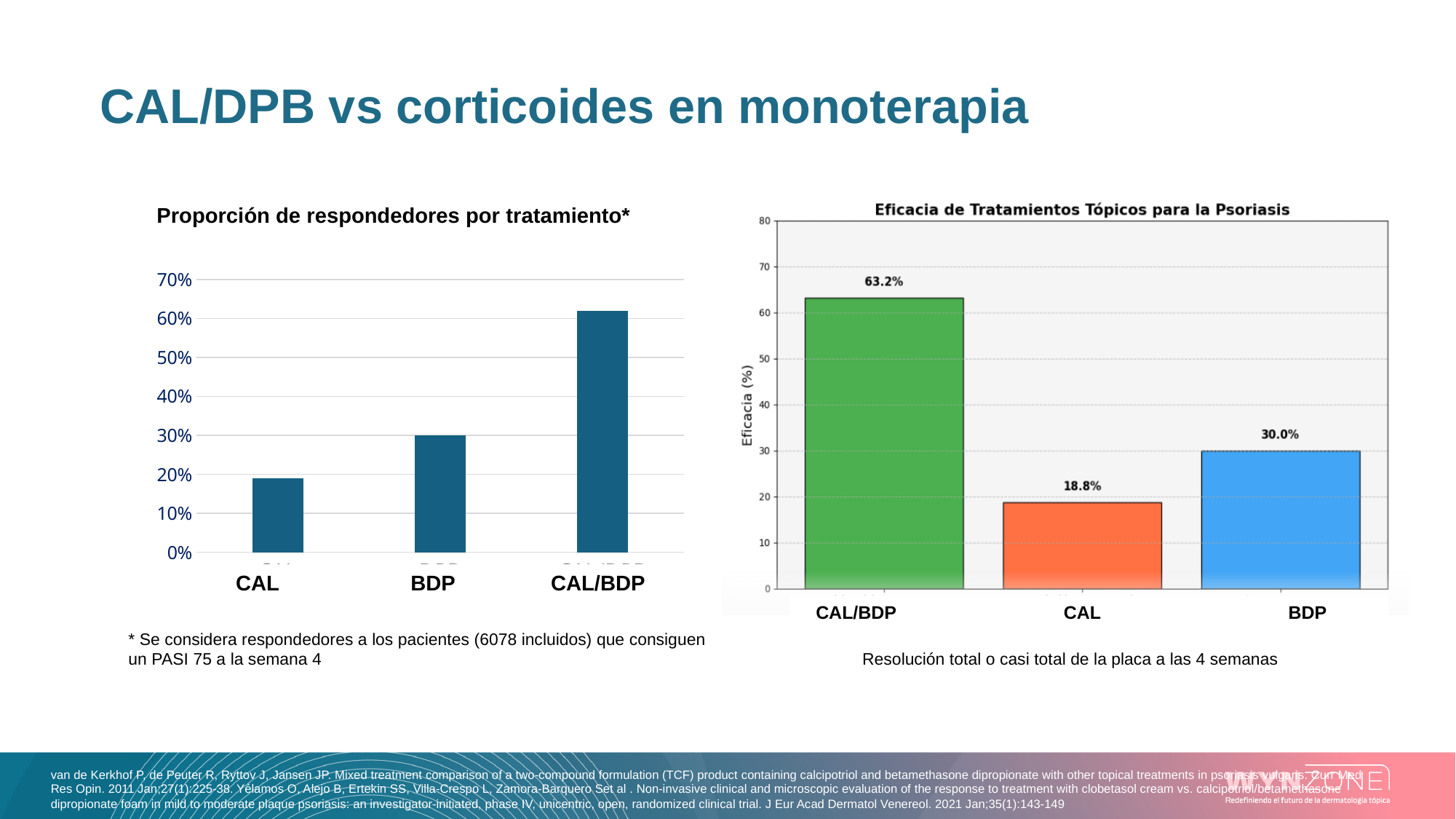
In the chart titled 'Proporción de respondedores por tratamiento*', which treatment has the highest proportion of responders? CAL/BDP In the chart titled 'Eficacia de Tratamientos Tópicos para la Psoriasis', which treatment has the highest efficacy? CAL/BDP In the chart titled 'Proporción de respondedores por tratamiento*', is the value for CAL/BDP greater or less than 50%? greater What kind of chart is the one titled 'Proporción de respondedores por tratamiento*'? Bar chart In the chart titled 'Eficacia de Tratamientos Tópicos para la Psoriasis', what is the value for CAL? 18.8% In the chart titled 'Proporción de respondedores por tratamiento*', which treatment has the lowest proportion of responders? CAL In the chart titled 'Eficacia de Tratamientos Tópicos para la Psoriasis', what is the value for CAL/BDP? 63.2% In the chart titled 'Eficacia de Tratamientos Tópicos para la Psoriasis', what is the value for BDP? 30.0% In the chart titled 'Eficacia de Tratamientos Tópicos para la Psoriasis', what is the difference between the CAL/BDP and BDP values? 33.2% In the chart titled 'Eficacia de Tratamientos Tópicos para la Psoriasis', which treatment has the lowest efficacy? CAL In the chart titled 'Eficacia de Tratamientos Tópicos para la Psoriasis', how many treatments are shown? 3